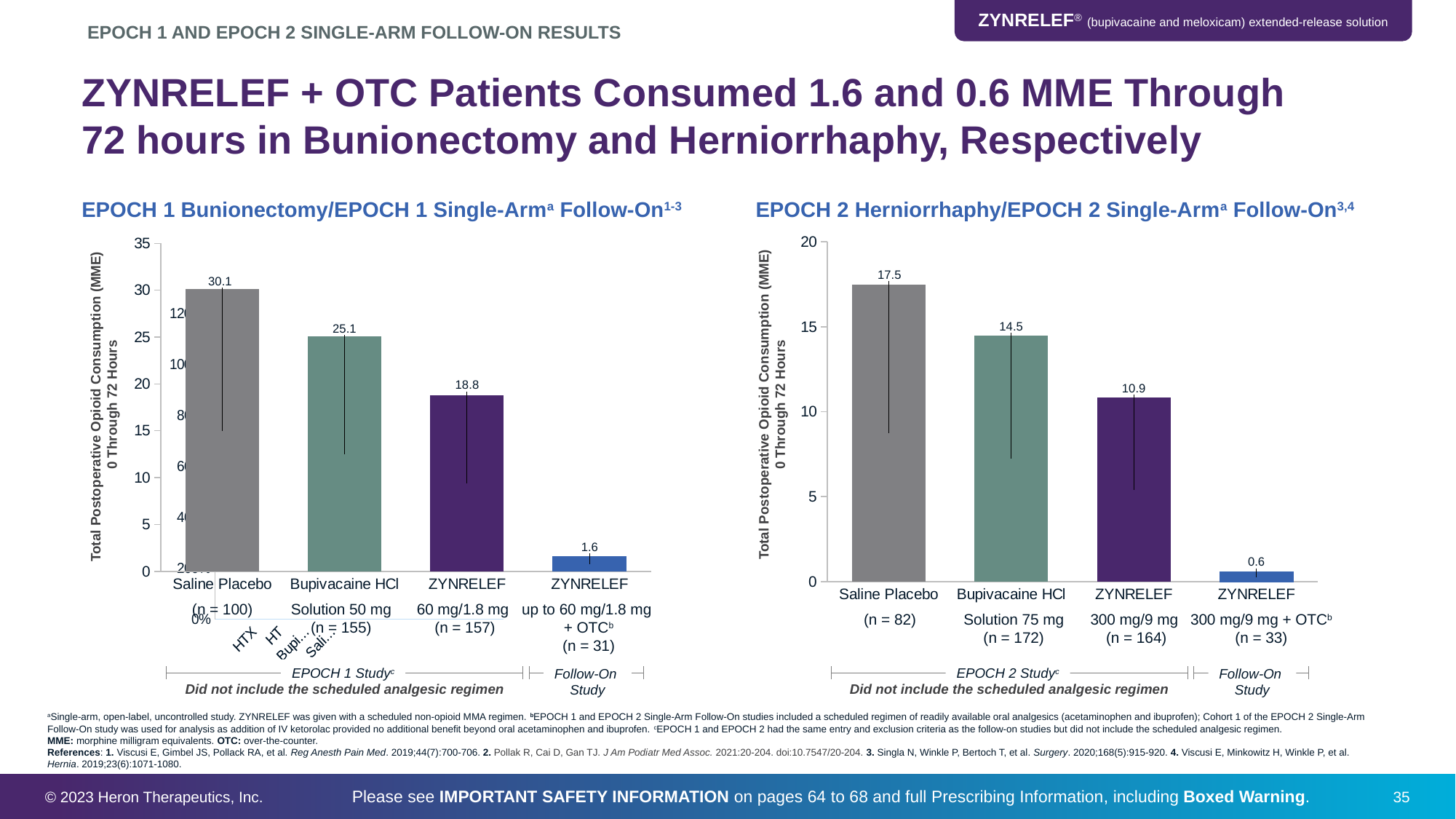
What type of chart is the EPOCH 2 Herniorrhaphy chart? Bar chart In the EPOCH 2 Herniorrhaphy chart, what is the difference between the Saline Placebo value and the Bupivacaine HCl value? 3.0 In the EPOCH 1 Bunionectomy chart, what is the value for ZYNRELEF up to 60 mg/1.8 mg + OTC? 1.6 In the EPOCH 1 Bunionectomy chart, which group has the highest opioid consumption? Saline Placebo In the EPOCH 2 Herniorrhaphy chart, what is the value for ZYNRELEF 300 mg/9 mg? 10.9 In the EPOCH 2 Herniorrhaphy chart, what is the value for Bupivacaine HCl Solution 75 mg? 14.5 In the EPOCH 2 Herniorrhaphy chart, which is larger: the value for Bupivacaine HCl or the value for ZYNRELEF 300 mg/9 mg? Bupivacaine HCl In the EPOCH 1 Bunionectomy chart, what is the total postoperative opioid consumption for Saline Placebo? 30.1 How many bars are shown in the EPOCH 2 Herniorrhaphy chart? 4 In the EPOCH 2 Herniorrhaphy chart, which group has the lowest opioid consumption? ZYNRELEF 300 mg/9 mg + OTC In the EPOCH 1 Bunionectomy chart, is the value for Bupivacaine HCl greater or less than 20? greater In the EPOCH 1 Bunionectomy chart, what is the difference between the Saline Placebo value and the ZYNRELEF 60 mg/1.8 mg value? 11.3